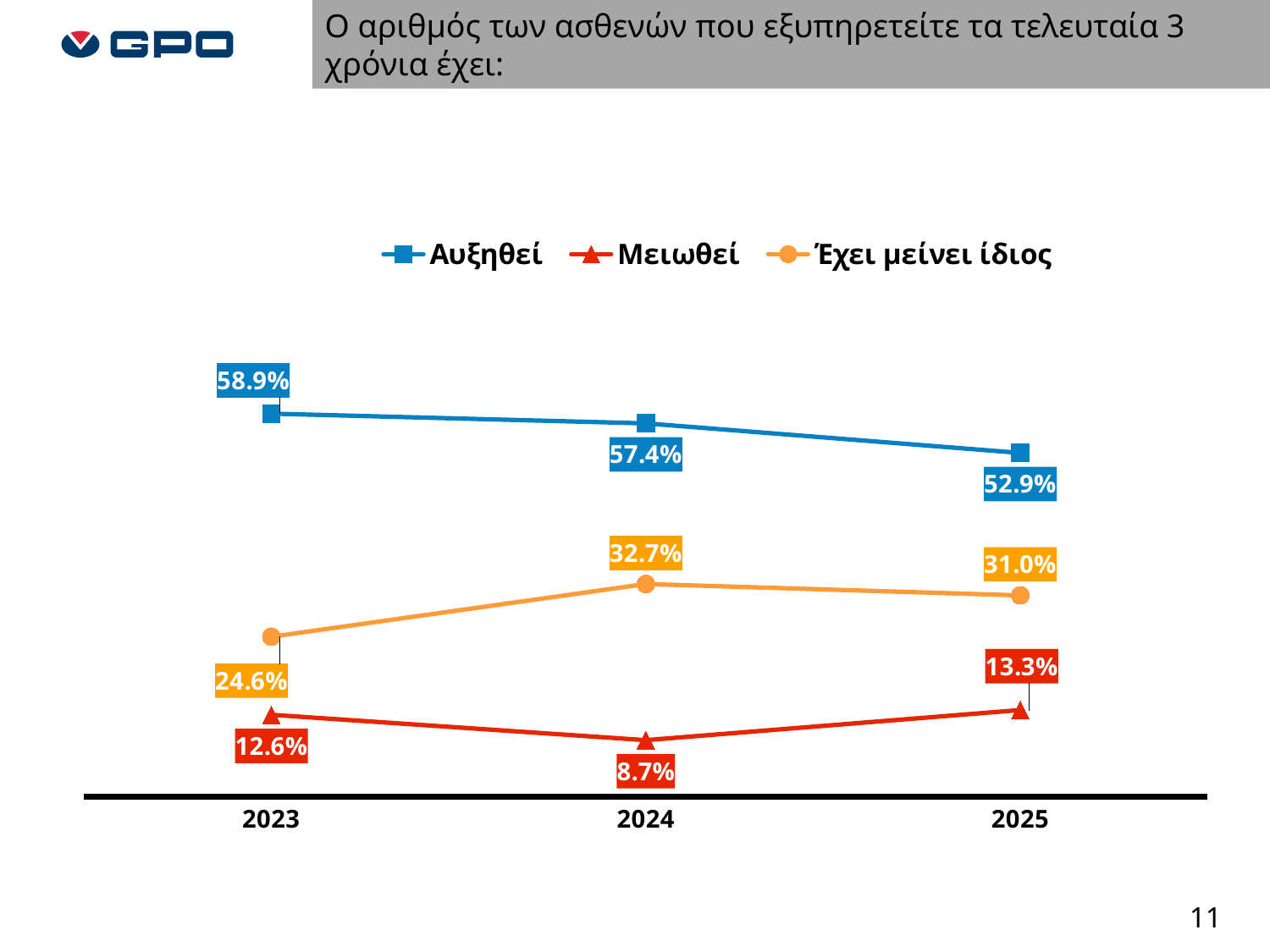
How many years are shown on the x axis? 3 What is the value for Μειωθεί in 2024? 8.7% What is the value for Αυξηθεί in 2023? 58.9% What kind of chart is shown on the slide? Line chart In which year is the value for Έχει μείνει ίδιος highest? 2024 Which colour is used for the Μειωθεί series? Red Which is larger in 2025: the value for Μειωθεί or the value for Έχει μείνει ίδιος? Έχει μείνει ίδιος What is the value for Έχει μείνει ίδιος in 2025? 31.0% Does the value for Αυξηθεί rise or fall from 2023 to 2025? Fall What is the difference between the Αυξηθεί values for 2023 and 2025? 6.0% In which year is the value for Μειωθεί lowest? 2024 How many series does the legend list? 3